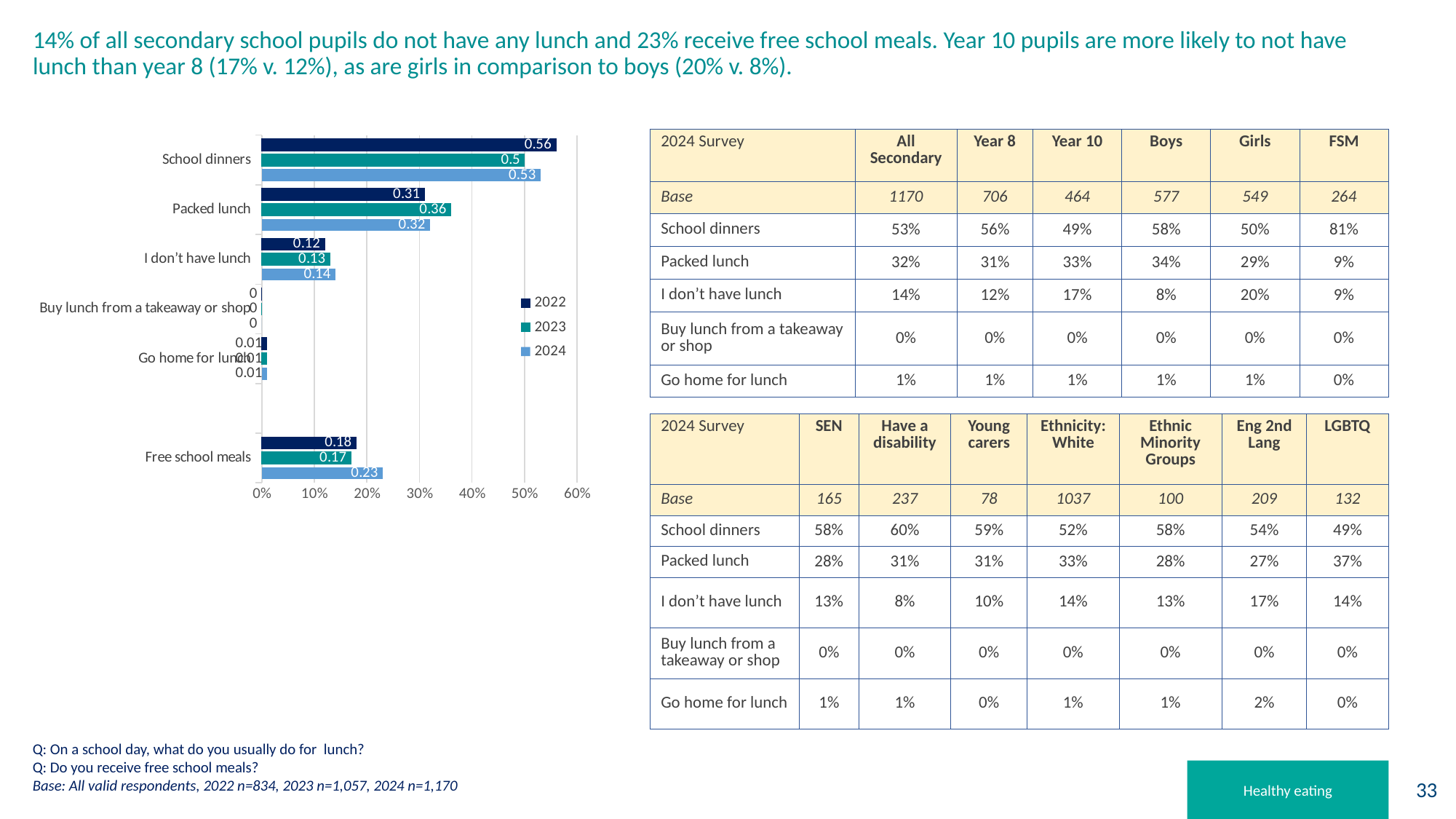
What is the 2024 value for I don't have lunch in the chart? 0.14 What is the 2024 value for Free school meals in the chart? 0.23 Which category has the highest 2024 value in the chart? School dinners In the chart, is the 2023 value for Packed lunch larger or smaller than the 2022 value for Packed lunch? larger How many categories are shown on the chart's vertical axis? 6 What is the difference between the 2024 and 2023 values for Free school meals in the chart? 0.06 What kind of chart is shown on the slide? bar chart What is the 2023 value for Packed lunch in the chart? 0.36 Which series in the chart legend is shown in the darkest blue colour? 2022 Is the 2024 value for School dinners in the chart greater or less than 50%? greater What is the 2022 value for School dinners in the chart? 0.56 How many series does the chart legend list? 3